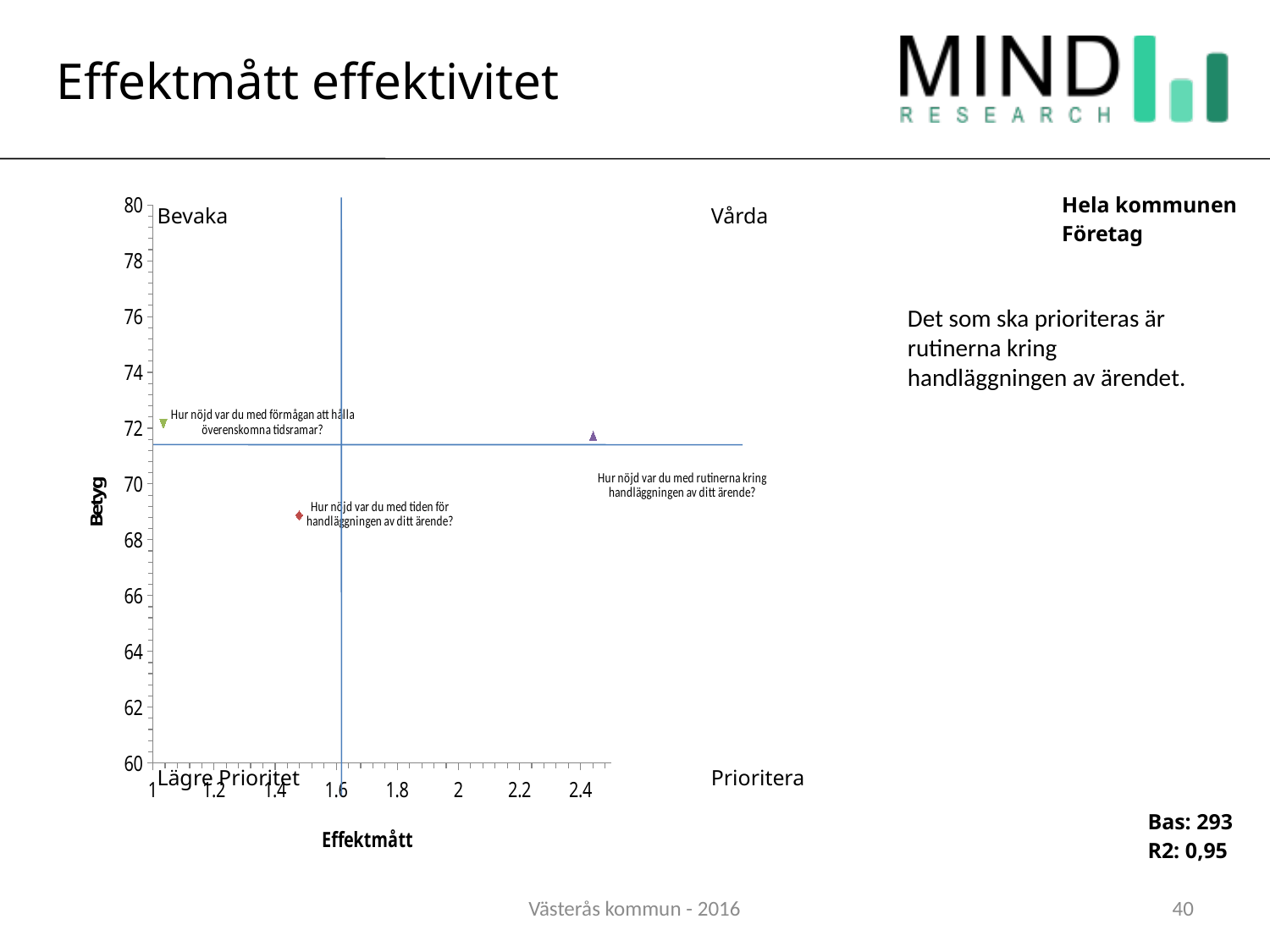
Which question has the lowest Betyg (y-axis) value? Hur nöjd var du med tiden för handläggningen av ditt ärende? Is the Effektmått value for 'Hur nöjd var du med rutinerna kring handläggningen av ditt ärende?' greater or less than 2? greater What is the title of the y-axis of the chart? Betyg What kind of chart is shown on the slide? scatter chart Which question has the highest Effektmått (x-axis) value? Hur nöjd var du med rutinerna kring handläggningen av ditt ärende? Which has the higher Betyg value: 'Hur nöjd var du med rutinerna kring handläggningen av ditt ärende?' or 'Hur nöjd var du med tiden för handläggningen av ditt ärende?' Hur nöjd var du med rutinerna kring handläggningen av ditt ärende? Is the Effektmått value for 'Hur nöjd var du med tiden för handläggningen av ditt ärende?' greater or less than 1.6? less What is the title of the x-axis of the chart? Effektmått Is the Betyg value for 'Hur nöjd var du med tiden för handläggningen av ditt ärende?' greater or less than 70? less How many data points are plotted in the chart? 3 Which question has the lowest Effektmått (x-axis) value? Hur nöjd var du med förmågan att hålla överenskomna tidsramar?